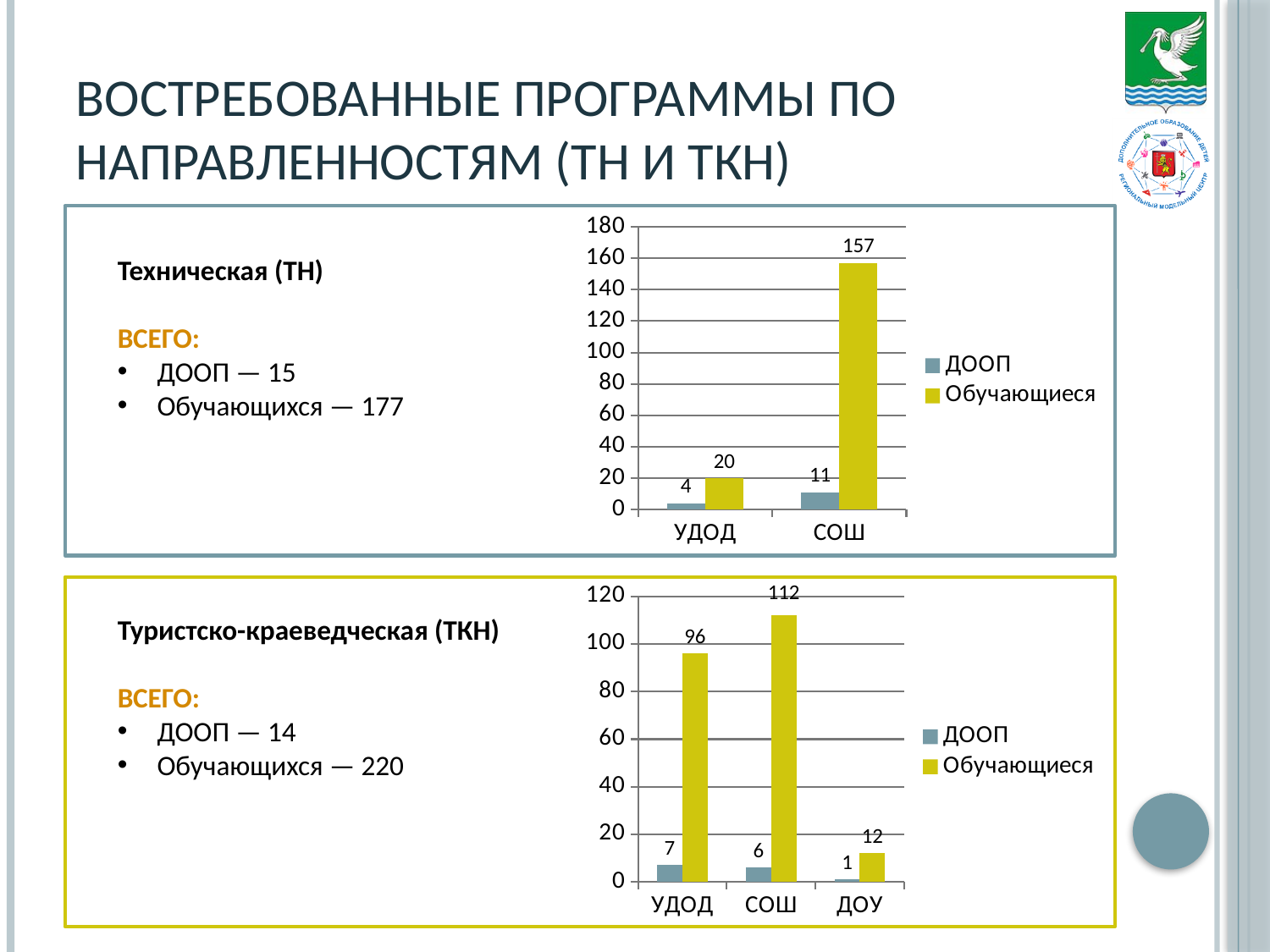
What kind of chart is the bottom chart (Туристско-краеведческая (ТКН))? bar chart In the top chart (Техническая (ТН)), what is the value of Обучающиеся for СОШ? 157 In the bottom chart (Туристско-краеведческая (ТКН)), how many categories are shown on the x axis? 3 In the bottom chart (Туристско-краеведческая (ТКН)), which category has the lowest ДООП value? ДОУ In the bottom chart (Туристско-краеведческая (ТКН)), which category has the highest Обучающиеся value? СОШ In the top chart (Техническая (ТН)), how many series does the legend list? 2 In the bottom chart (Туристско-краеведческая (ТКН)), what is the value of Обучающиеся for УДОД? 96 In the top chart (Техническая (ТН)), which category has the higher ДООП value, УДОД or СОШ? СОШ In the top chart (Техническая (ТН)), what colour are the Обучающиеся bars? yellow In the bottom chart (Туристско-краеведческая (ТКН)), what is the difference between Обучающиеся for СОШ and Обучающиеся for ДОУ? 100 In the top chart (Техническая (ТН)), what is the value of ДООП for УДОД? 4 In the top chart (Техническая (ТН)), what is the difference between Обучающиеся for СОШ and Обучающиеся for УДОД? 137